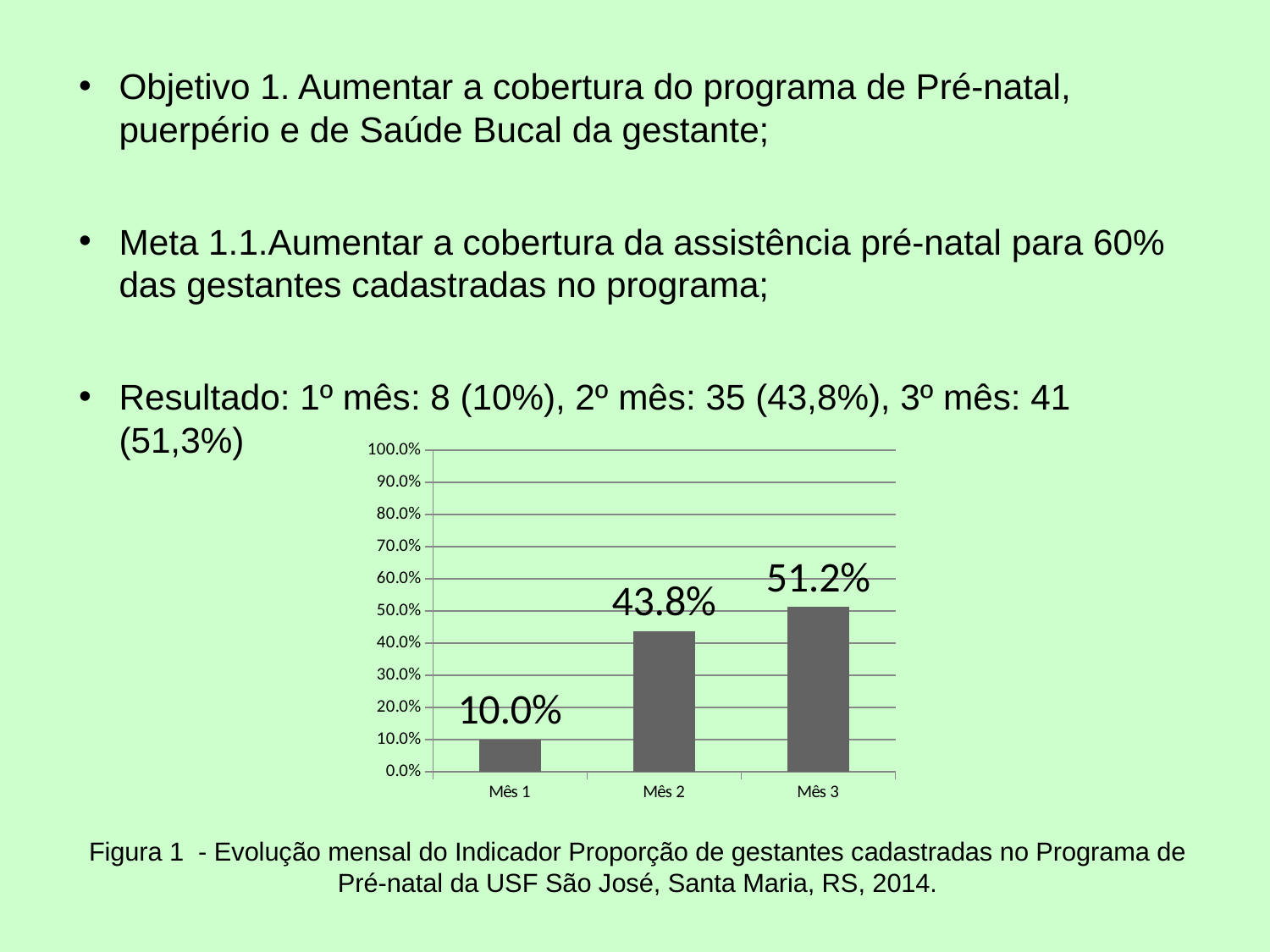
Do the values rise or fall from Mês 1 to Mês 3? rise What is the difference between the values for Mês 2 and Mês 1? 33.8% Which is larger, the value for Mês 1 or the value for Mês 2? Mês 2 What is the value for Mês 2? 43.8% Which month has the highest value? Mês 3 How many months are shown on the x axis? 3 What is the difference between the values for Mês 3 and Mês 2? 7.4% What kind of chart is shown on the slide? bar chart Is the value for Mês 3 greater or less than 60.0%? less What is the value for Mês 3? 51.2% What is the value for Mês 1? 10.0% Which month has the lowest value? Mês 1